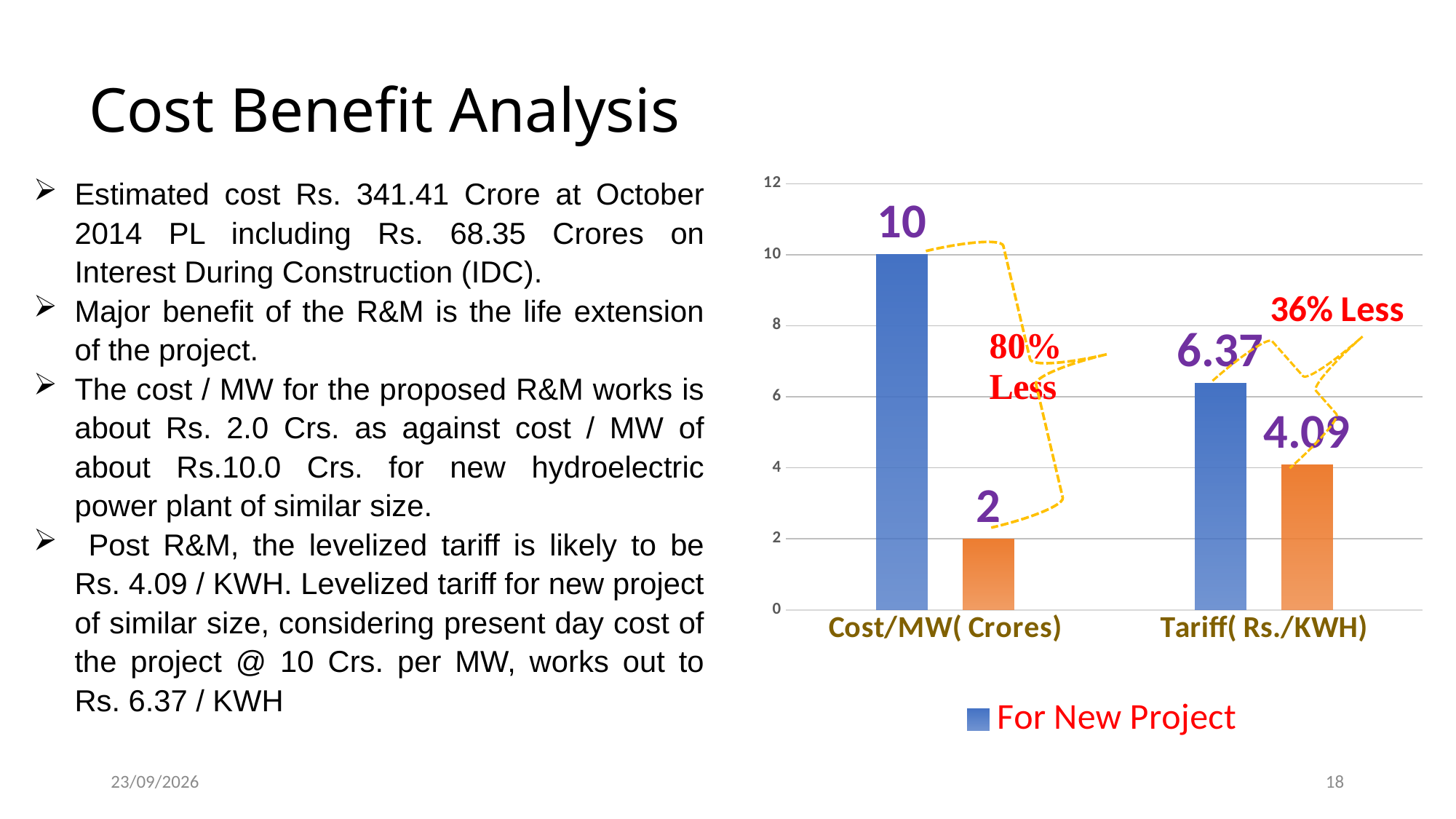
What annotation is written between the two Cost/MW( Crores) bars? 80% Less Which bar in the chart has the highest value? For New Project, Cost/MW( Crores) For Tariff( Rs./KWH), which bar is larger, the For New Project bar or the orange bar? For New Project What is the value of the For New Project bar for Tariff( Rs./KWH)? 6.37 What is the value of the orange bar for Cost/MW( Crores)? 2 What is the value of the For New Project bar for Cost/MW( Crores)? 10 What kind of chart is shown on the slide? Bar chart What is the difference between the For New Project bar and the orange bar for Cost/MW( Crores)? 8 Which bar in the chart has the lowest value? The orange bar for Cost/MW( Crores) What is the difference between the For New Project bar and the orange bar for Tariff( Rs./KWH)? 2.28 What is the value of the orange bar for Tariff( Rs./KWH)? 4.09 How many categories are shown on the x axis of the chart? 2